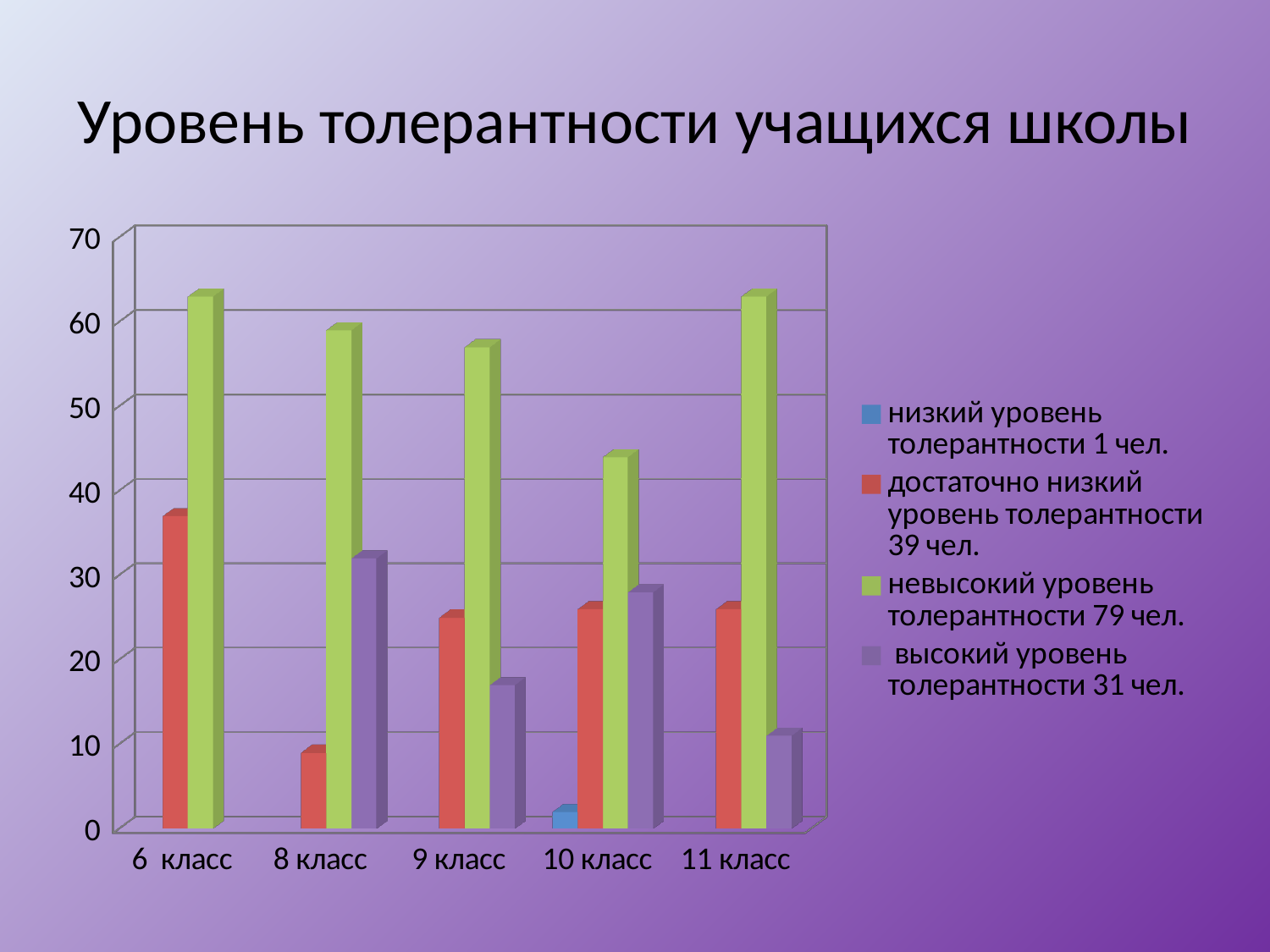
Which class has the lowest value for 'достаточно низкий уровень толерантности 39 чел.'? 8 класс Which class has the highest value for 'достаточно низкий уровень толерантности 39 чел.'? 6 класс Which class is the only one with a bar for 'низкий уровень толерантности 1 чел.'? 10 класс How many series does the legend list? 4 Which class has the lowest value for 'невысокий уровень толерантности 79 чел.'? 10 класс What kind of chart is shown on the slide? bar chart In 9 класс, which is larger: 'достаточно низкий уровень толерантности 39 чел.' or 'высокий уровень толерантности 31 чел.'? достаточно низкий уровень толерантности 39 чел. Is the value for 'невысокий уровень толерантности 79 чел.' in 10 класс greater or less than 50? less How many class categories are shown on the x axis? 5 What is the title of the slide? Уровень толерантности учащихся школы Is the value for 'невысокий уровень толерантности 79 чел.' in 6 класс greater or less than 60? greater